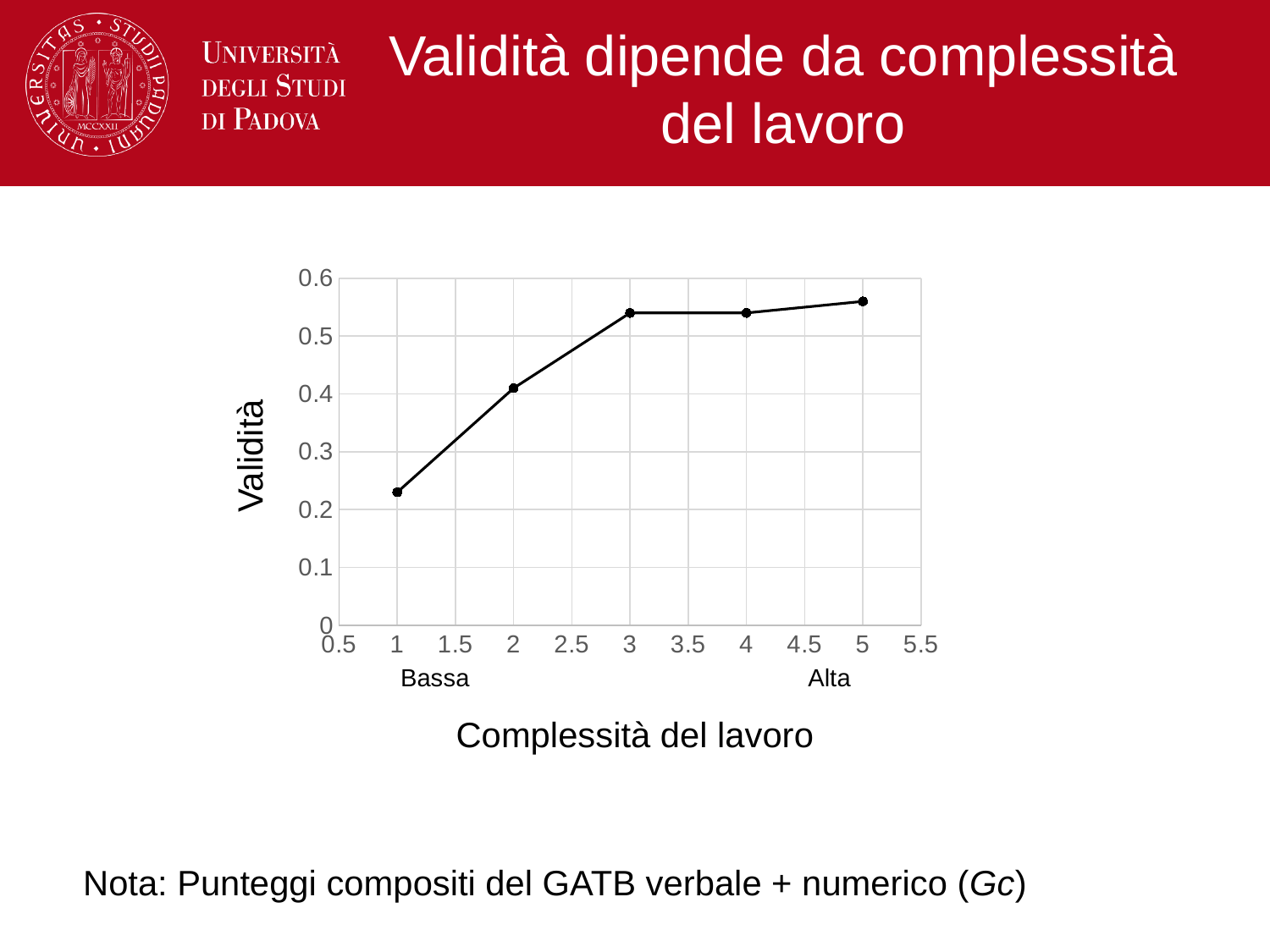
Is the validity value at complexity 3 greater or less than 0.5? greater Is the validity value at complexity 1 greater or less than 0.3? less What is the title of the x axis? Complessità del lavoro At which x value (complexity level) is validity lowest? 1 What kind of chart is shown on the slide? line chart Do the values rise or fall as job complexity increases along the x axis? rise At which x value (complexity level) is validity highest? 5 Which has the larger validity value: complexity 1 or complexity 2? complexity 2 Is the validity value at complexity 5 greater or less than 0.6? less How many data points are plotted on the line? 5